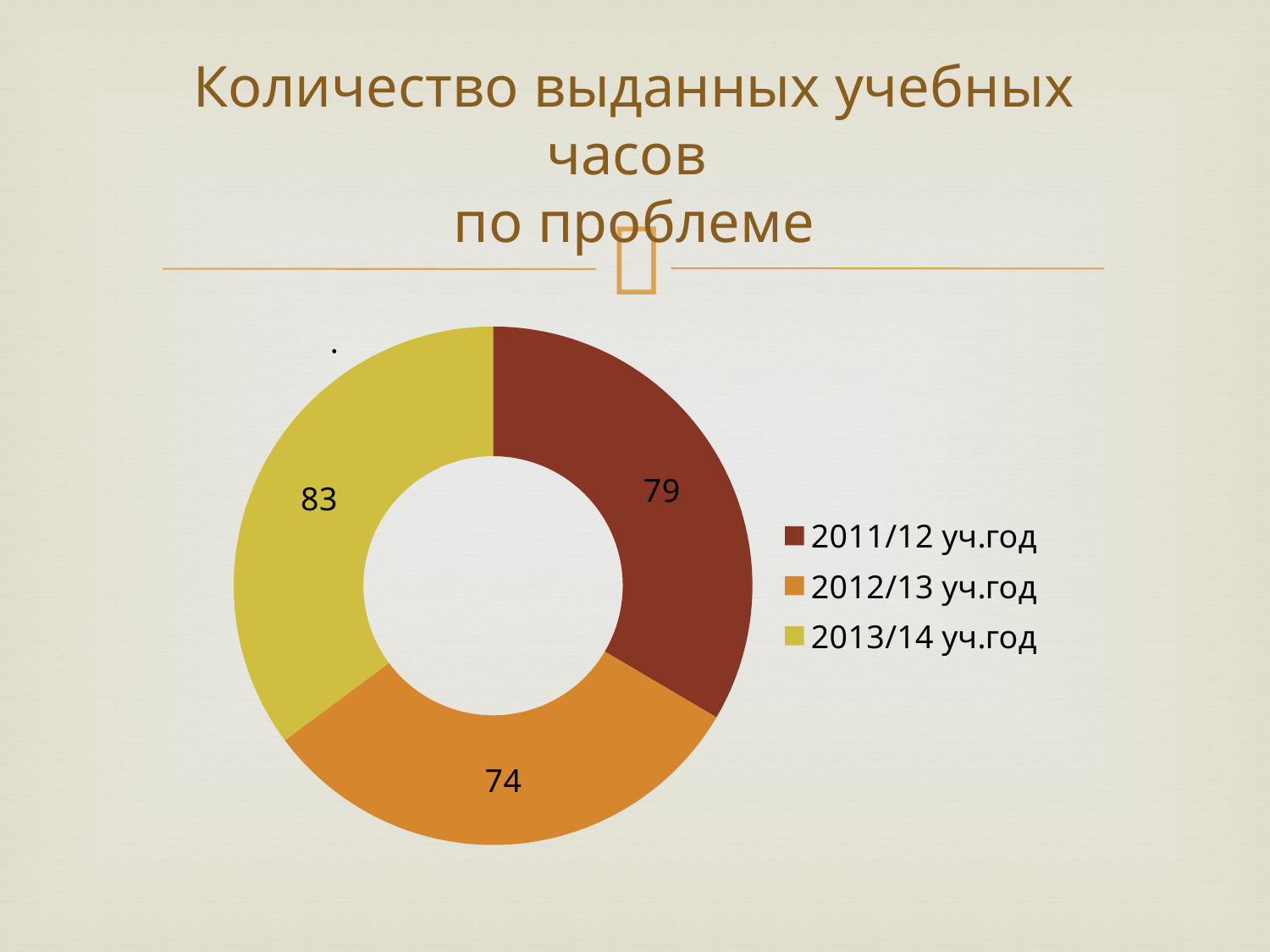
What value is shown for 2013/14 уч.год? 83 What is the difference between the values for 2013/14 уч.год and 2012/13 уч.год? 9 Which academic year has the lowest value? 2012/13 уч.год What is the title of the slide? Количество выданных учебных часов по проблеме What is the difference between the values for 2011/12 уч.год and 2012/13 уч.год? 5 Which is larger, the value for 2011/12 уч.год or 2013/14 уч.год? 2013/14 уч.год What value is shown for 2012/13 уч.год? 74 Which academic year has the highest value? 2013/14 уч.год How many categories does the chart show? 3 What is the total of all three values in the chart? 236 What kind of chart is shown on the slide? Doughnut (pie) chart What value is shown for 2011/12 уч.год? 79